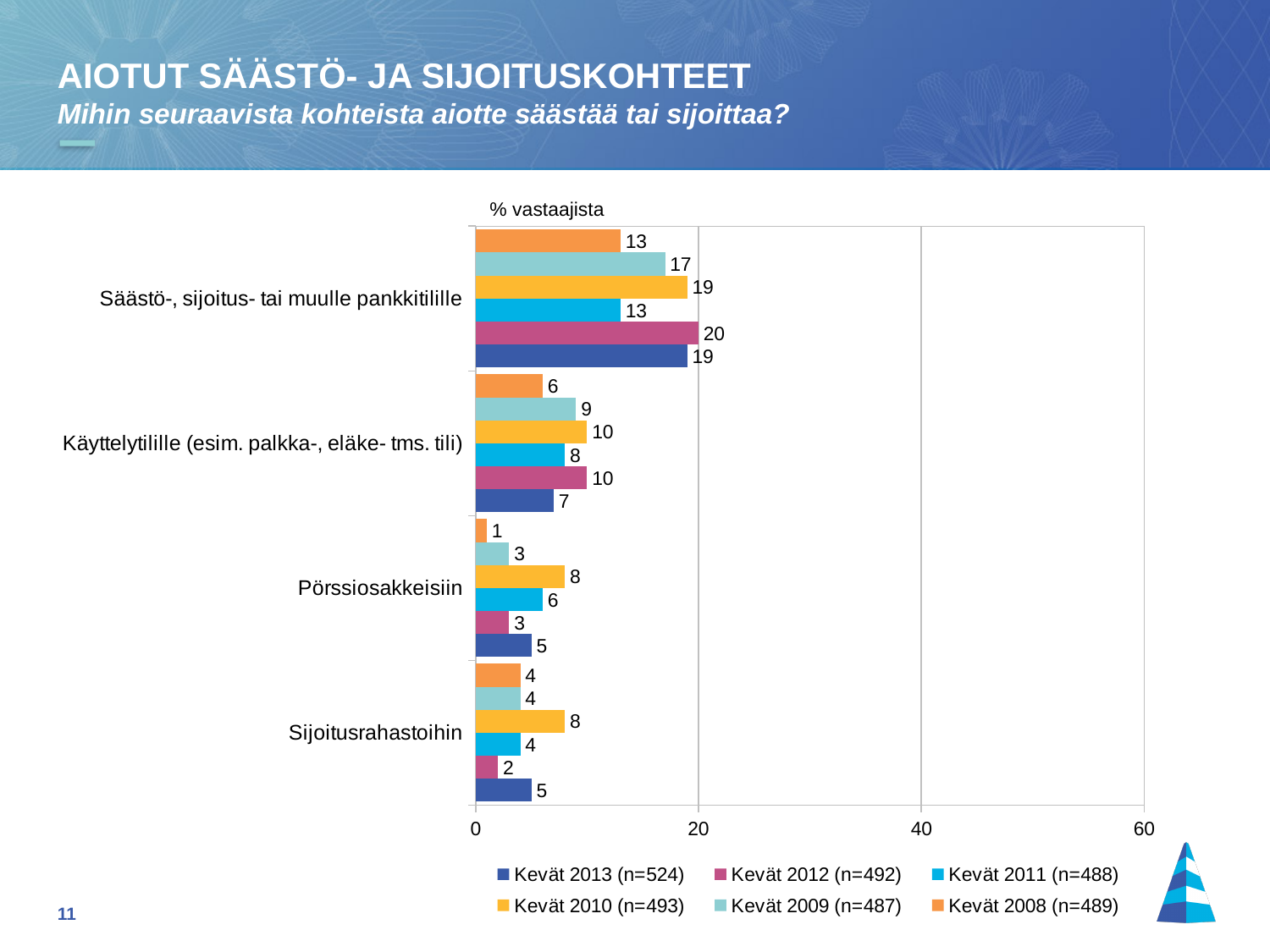
Which is larger for Sijoitusrahastoihin: the Kevät 2010 value or the Kevät 2012 value? Kevät 2010 What kind of chart is shown on the slide? Bar chart What is the value for Kevät 2013 for Pörssiosakkeisiin? 5 What is the difference between the Kevät 2012 and Kevät 2011 values for Säästö-, sijoitus- tai muulle pankkitilille? 7 What is the value for Kevät 2012 for Säästö-, sijoitus- tai muulle pankkitilille? 20 What is the value for Kevät 2008 for Käyttelytilille (esim. palkka-, eläke- tms. tili)? 6 How many categories are shown on the chart? 4 Which category has the highest value for Kevät 2013? Säästö-, sijoitus- tai muulle pankkitilille How many series does the legend list? 6 Is the value for Kevät 2009 for Säästö-, sijoitus- tai muulle pankkitilille greater or less than 20? less What is the value for Kevät 2010 for Sijoitusrahastoihin? 8 Which series has the lowest value for Pörssiosakkeisiin? Kevät 2008 (n=489)